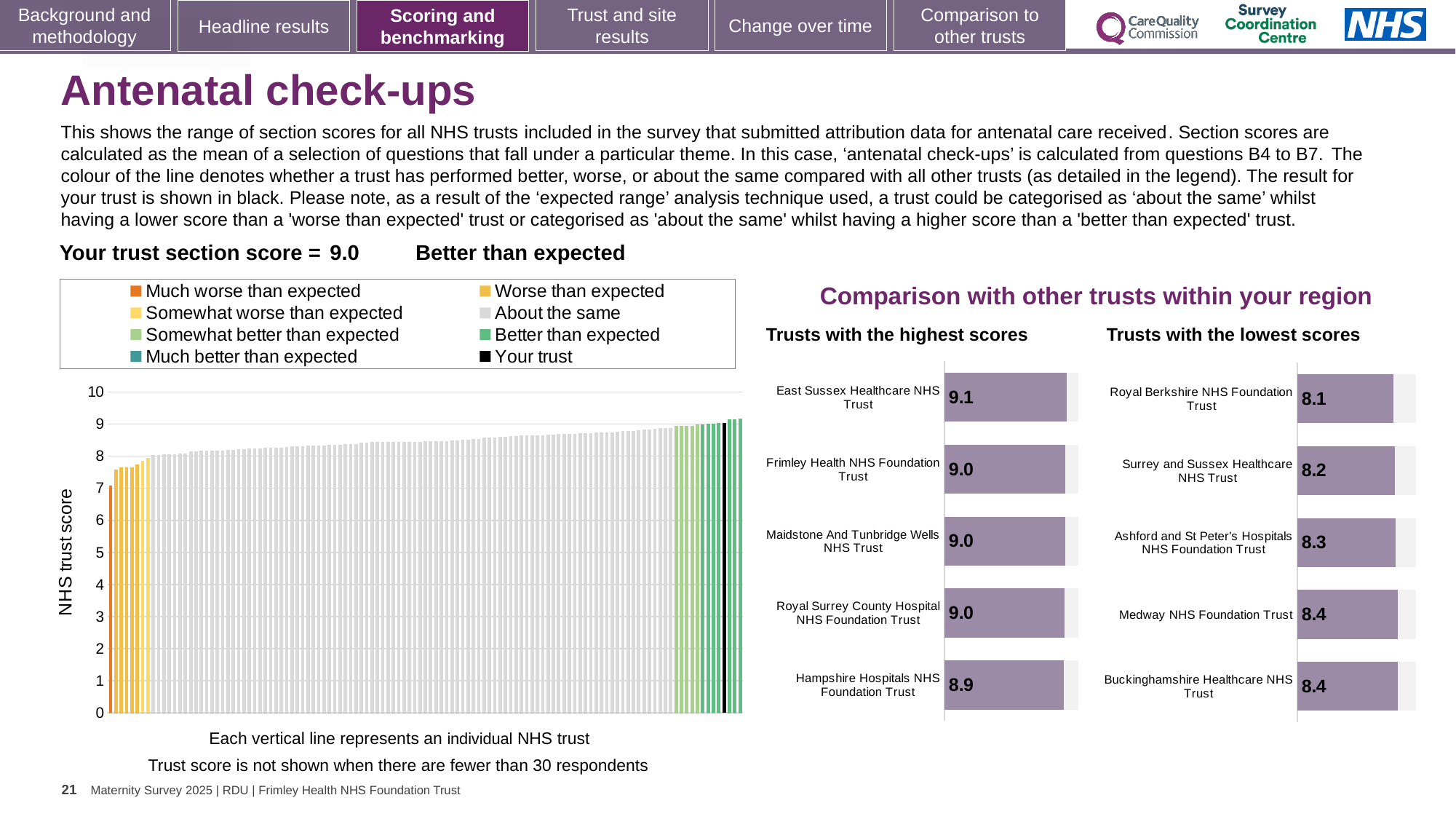
In the 'Trusts with the lowest scores' chart, which has the larger score: Surrey and Sussex Healthcare NHS Trust or Ashford and St Peter's Hospitals NHS Foundation Trust? Ashford and St Peter's Hospitals NHS Foundation Trust What kind of chart is the 'Trusts with the highest scores' chart? bar chart In the 'Trusts with the lowest scores' chart, which trust has the lowest score? Royal Berkshire NHS Foundation Trust In the large 'NHS trust score' chart on the left, is the value of the leftmost bar greater or less than 8? less In the 'Trusts with the highest scores' chart, what is the score for East Sussex Healthcare NHS Trust? 9.1 In the 'Trusts with the lowest scores' chart, what is the score for Royal Berkshire NHS Foundation Trust? 8.1 How many entries does the legend above the large 'NHS trust score' chart list? 8 In the 'Trusts with the highest scores' chart, what is the difference between the scores of East Sussex Healthcare NHS Trust and Hampshire Hospitals NHS Foundation Trust? 0.2 In the 'Trusts with the highest scores' chart, which trust has the highest score? East Sussex Healthcare NHS Trust In the 'Trusts with the lowest scores' chart, how many trusts are shown? 5 In the 'Trusts with the highest scores' chart, what is the score for Hampshire Hospitals NHS Foundation Trust? 8.9 In the large 'NHS trust score' chart on the left, do the bar values rise or fall from left to right? rise